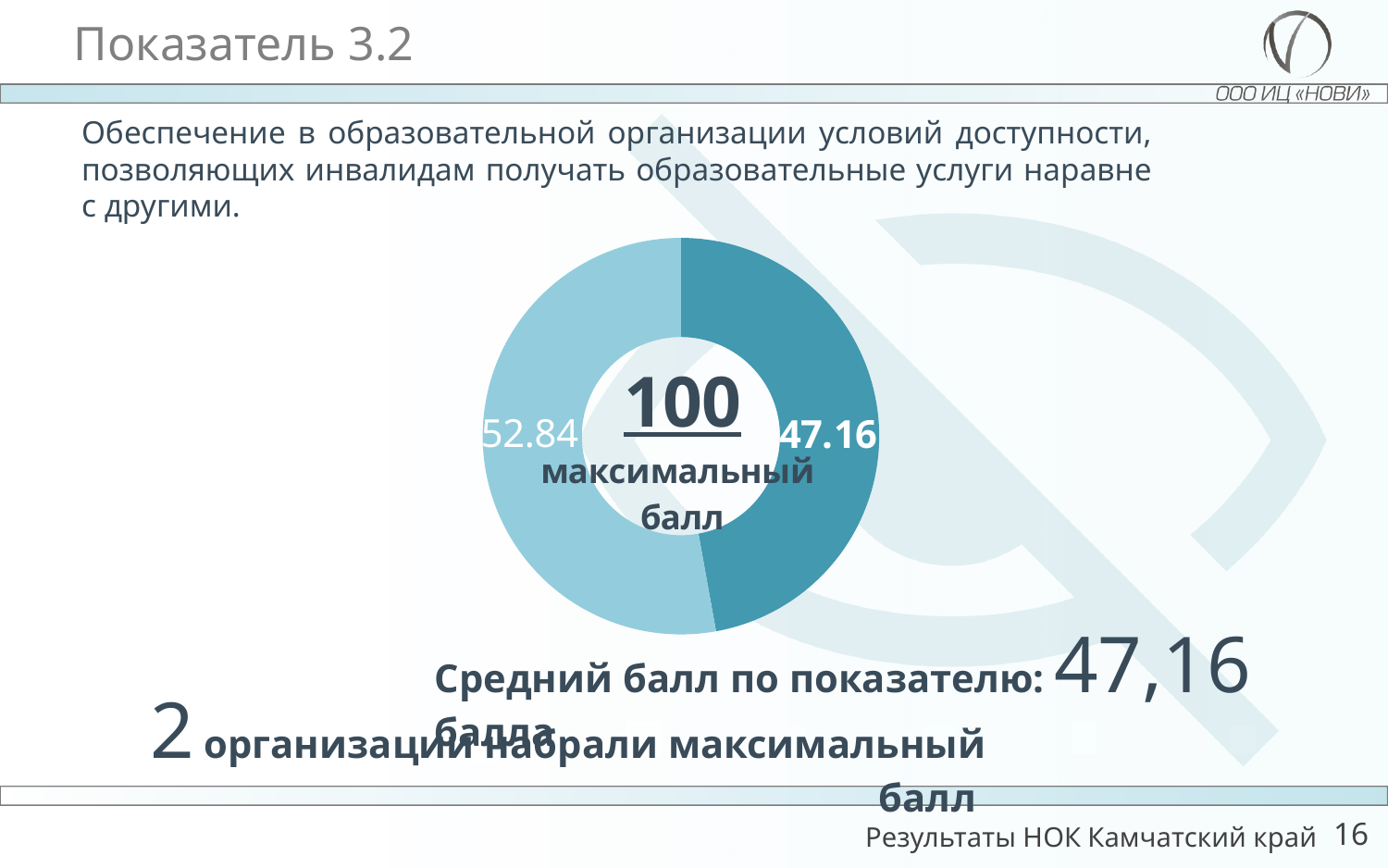
What is the largest value shown on the doughnut chart? 52.84 Which slice of the doughnut chart is larger, the one labelled 47.16 or the one labelled 52.84? 52.84 What number is printed in the centre of the doughnut chart? 100 What share of the whole doughnut does the dark teal slice (47.16) represent? 47.16% How many slices does the doughnut chart have? 2 What is the total of the two slice values on the doughnut chart? 100 What is the smallest value shown on the doughnut chart? 47.16 What value is labelled on the light blue slice of the doughnut chart? 52.84 What kind of chart is shown on the slide? doughnut chart What text appears below the number in the centre of the doughnut chart? максимальный балл What is the difference between the two slice values on the doughnut chart? 5.68 What value is labelled on the dark teal slice of the doughnut chart? 47.16